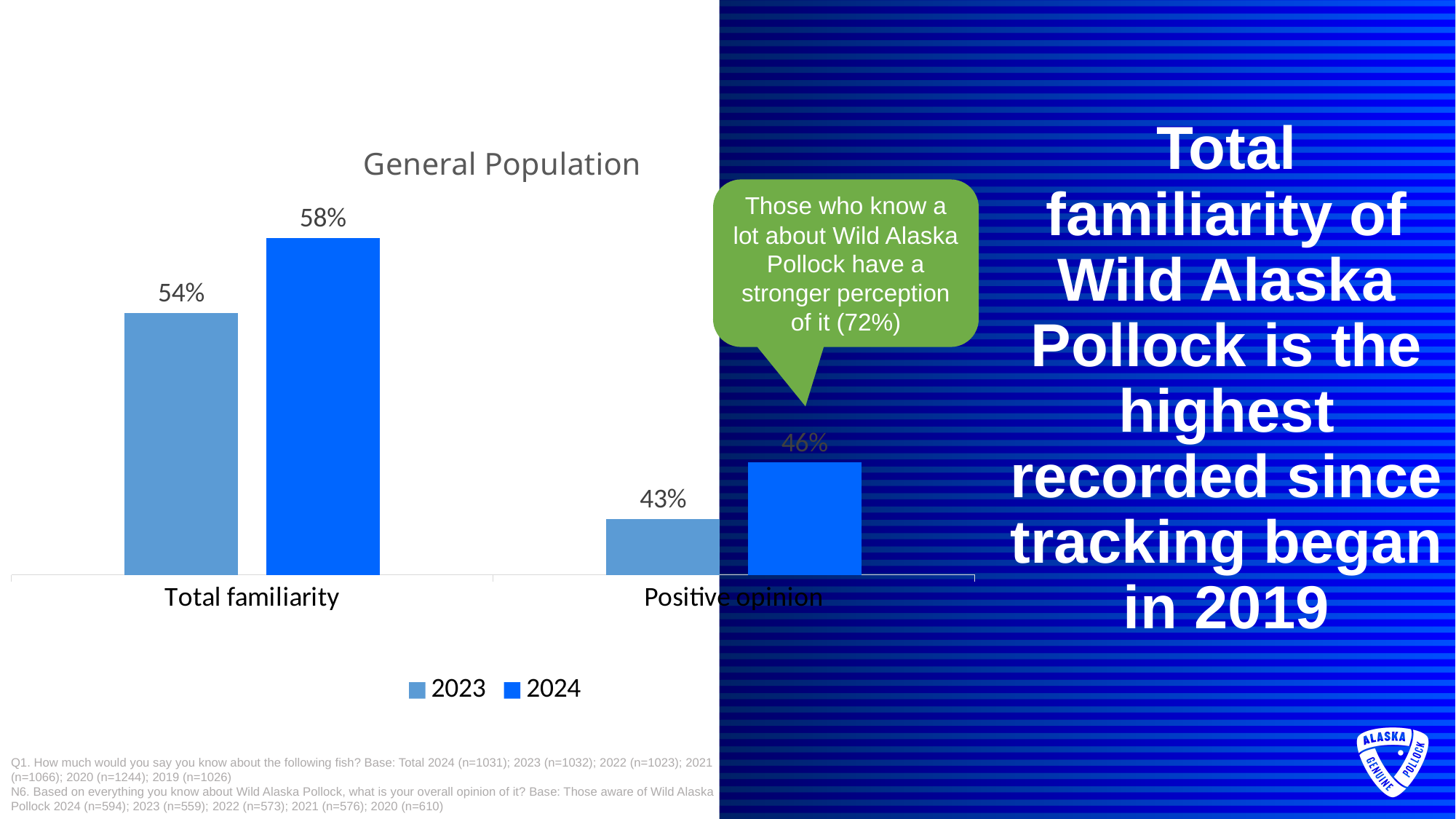
How many series does the legend list? 2 What is the difference between the 2024 and 2023 values for Positive opinion? 3% Which category has the highest 2024 value? Total familiarity What kind of chart is shown? Bar chart What is the 2023 value for Positive opinion? 43% What is the difference between the 2024 and 2023 values for Total familiarity? 4% How many categories are shown on the x axis? 2 What is the 2024 value for Positive opinion? 46% Which category has the lowest 2023 value? Positive opinion What is the 2024 value for Total familiarity? 58% Which is larger for Positive opinion, the 2023 value or the 2024 value? 2024 What is the 2023 value for Total familiarity? 54%